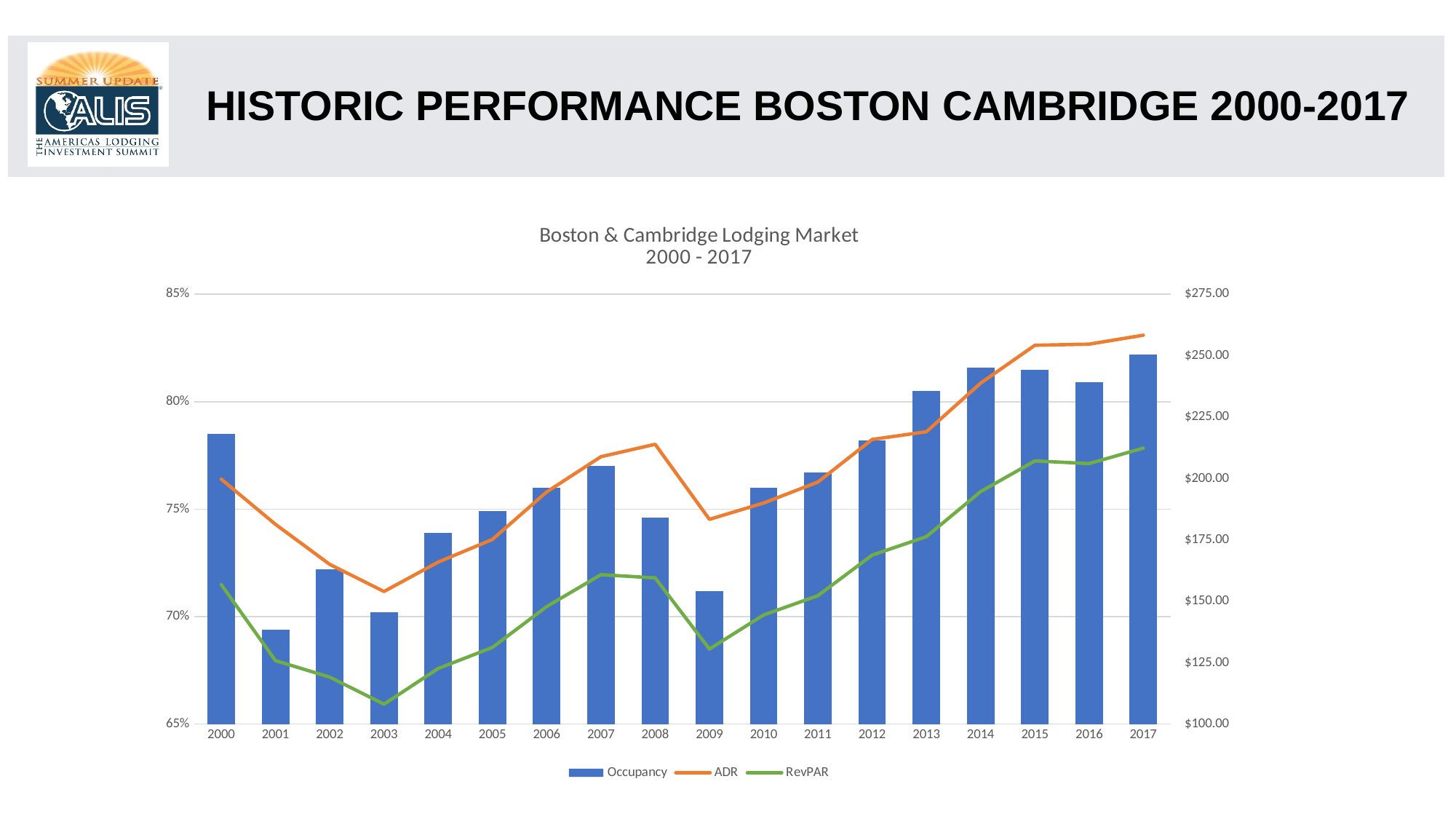
Which year has the lowest RevPAR? 2003 Which year has the higher Occupancy, 2008 or 2009? 2008 Is the Occupancy value for 2000 greater or less than 75%? greater Is the ADR value for 2017 greater or less than $250.00? greater Which year has the lowest Occupancy? 2001 Which year has the highest ADR? 2017 How many series does the legend list? 3 Does ADR rise or fall from 2009 to 2017? Rise How many years are shown on the x axis? 18 What kind of chart is shown on the slide? Combined bar and line chart Which year has the lowest ADR? 2003 Is the RevPAR value for 2009 greater or less than $150.00? less